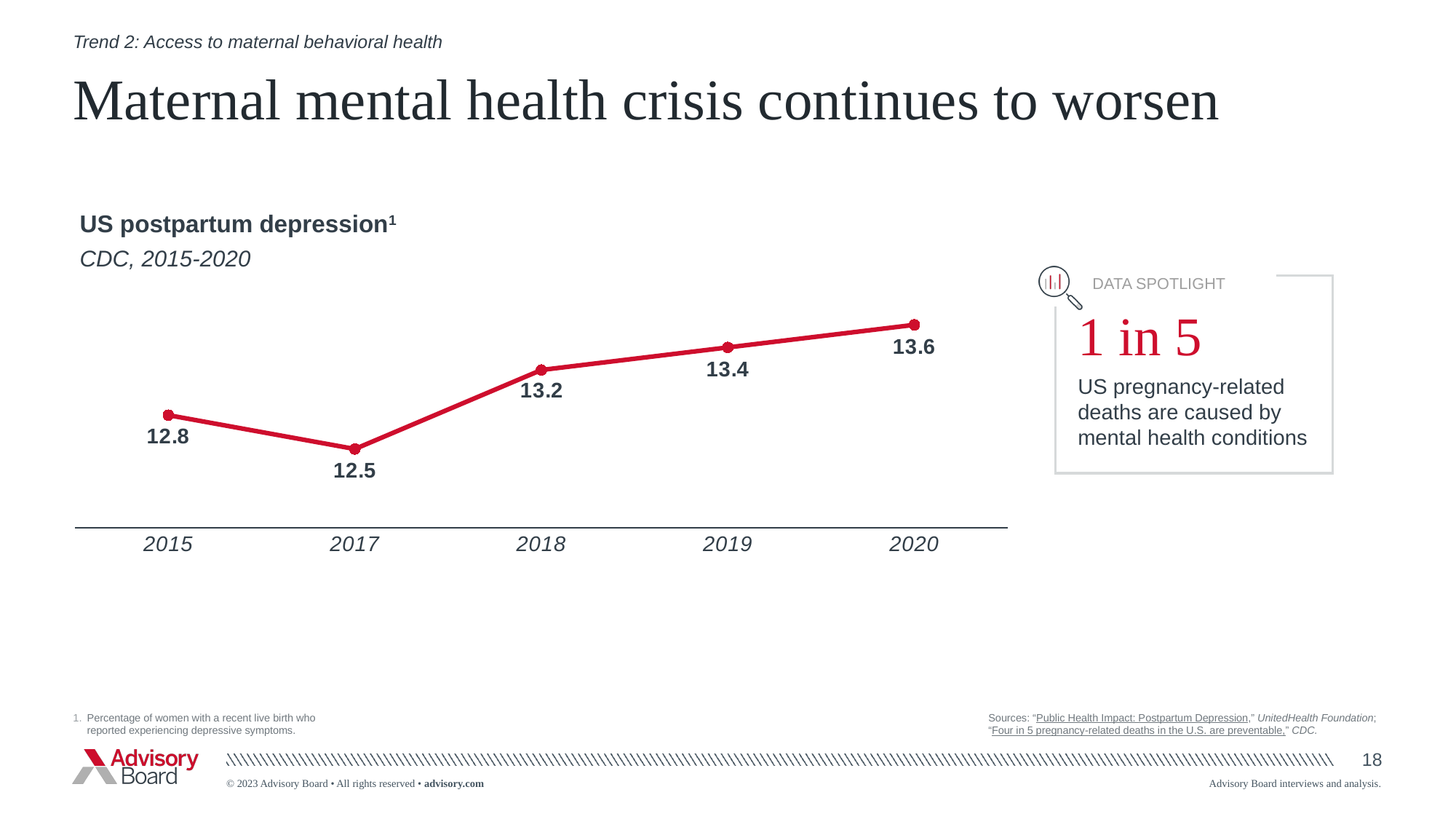
Which is larger, the value for 2019 or the value for 2015? 2019 What is the difference between the values for 2020 and 2015? 0.8 Which year has the lowest value? 2017 What kind of chart is shown on the slide? Line chart What is the title of the chart? US postpartum depression How many data points are plotted on the chart? 5 What is the value for 2017? 12.5 What is the value for 2015? 12.8 What is the value for 2020? 13.6 Which year has the highest value? 2020 Do the values rise or fall from 2017 to 2020? Rise What is the difference between the values for 2018 and 2017? 0.7